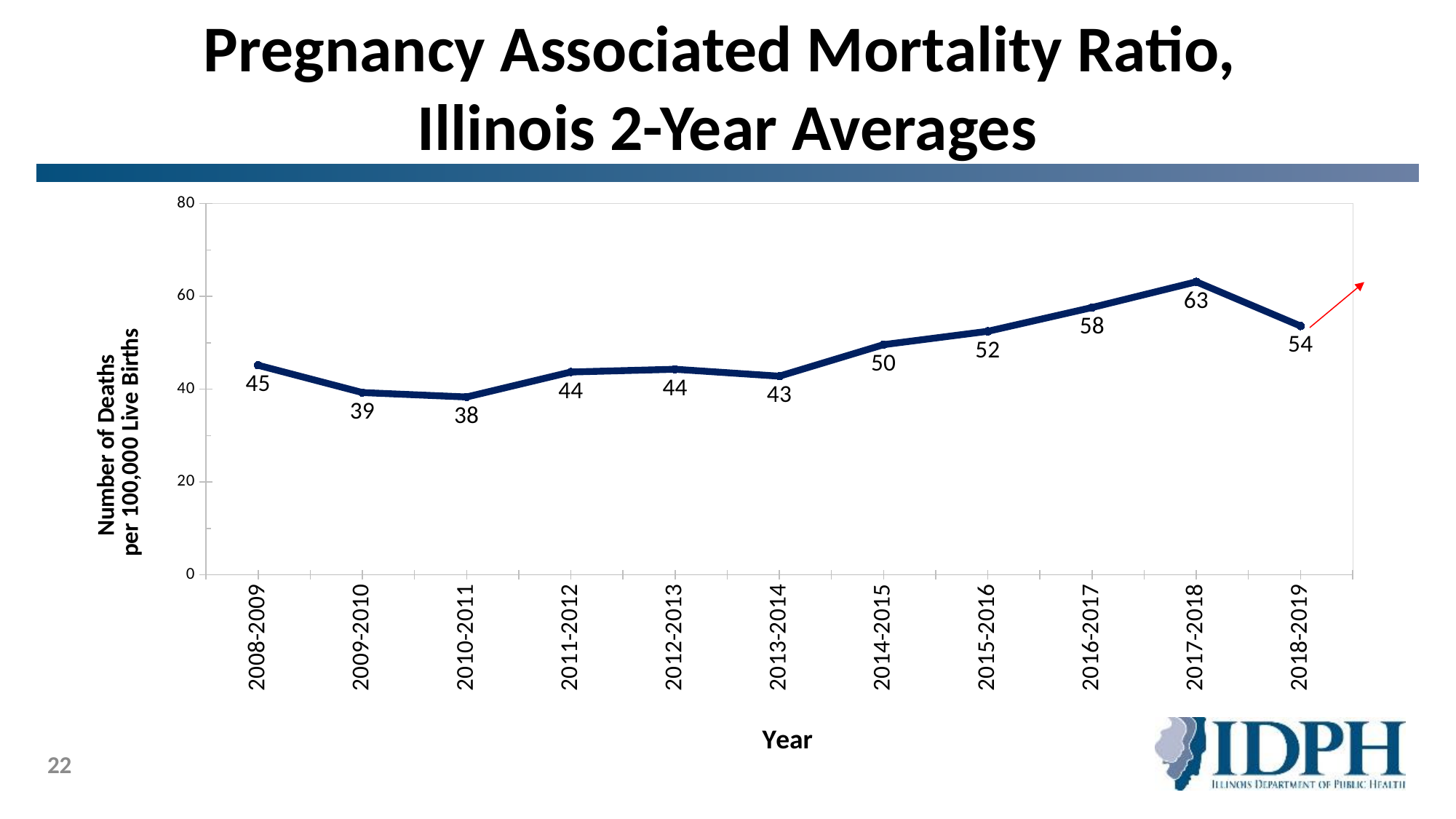
What is the label of the y axis? Number of Deaths per 100,000 Live Births What kind of chart is shown on the slide? Line chart What is the difference between the values for 2016-2017 and 2015-2016? 6 Which period has the highest value? 2017-2018 Which is larger, the value for 2014-2015 or the value for 2009-2010? 2014-2015 What is the value for 2008-2009? 45 What is the value for 2018-2019? 54 What is the difference between the values for 2017-2018 and 2018-2019? 9 Which period has the lowest value? 2010-2011 What is the value for 2017-2018? 63 What is the value for 2013-2014? 43 How many periods are plotted on the x axis? 11